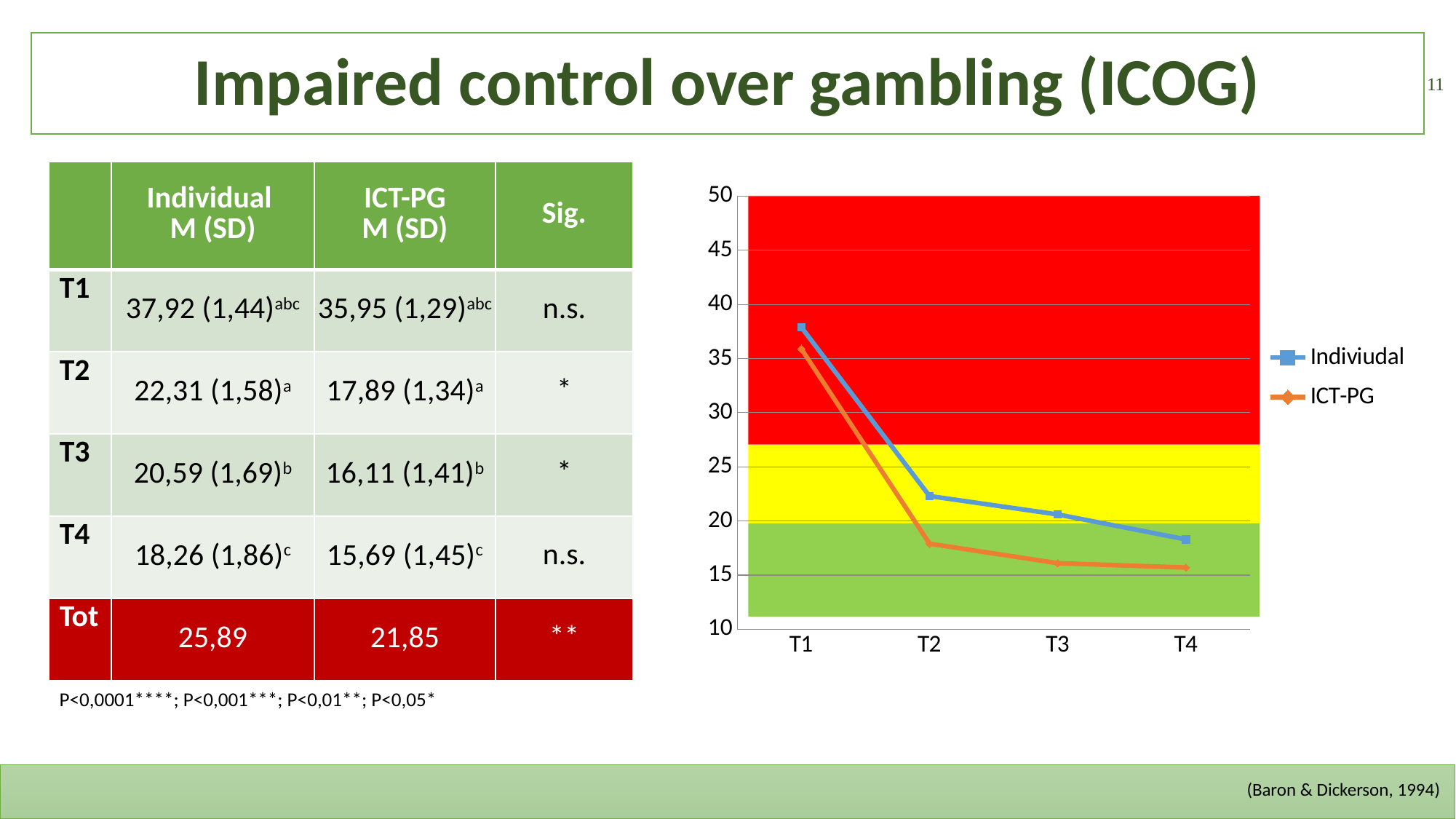
Do the values of the Individual series rise or fall from T1 to T4? fall How many time points are plotted along the x axis of the chart? 4 Is the value for the ICT-PG series at T2 greater or less than 20? less At which time point is the Individual series highest? T1 According to the table on the slide, what is the mean (M) for the Individual group at T1? 37,92 At which time point is the ICT-PG series lowest? T4 What kind of chart is shown on the right of the slide? line chart At T1, which series has the higher value, Individual or ICT-PG? Individual How many series does the chart's legend list? 2 Is the value for the Individual series at T1 greater or less than 35? greater What colour is the ICT-PG line in the chart? orange Is the value for the ICT-PG series at T4 greater or less than 20? less